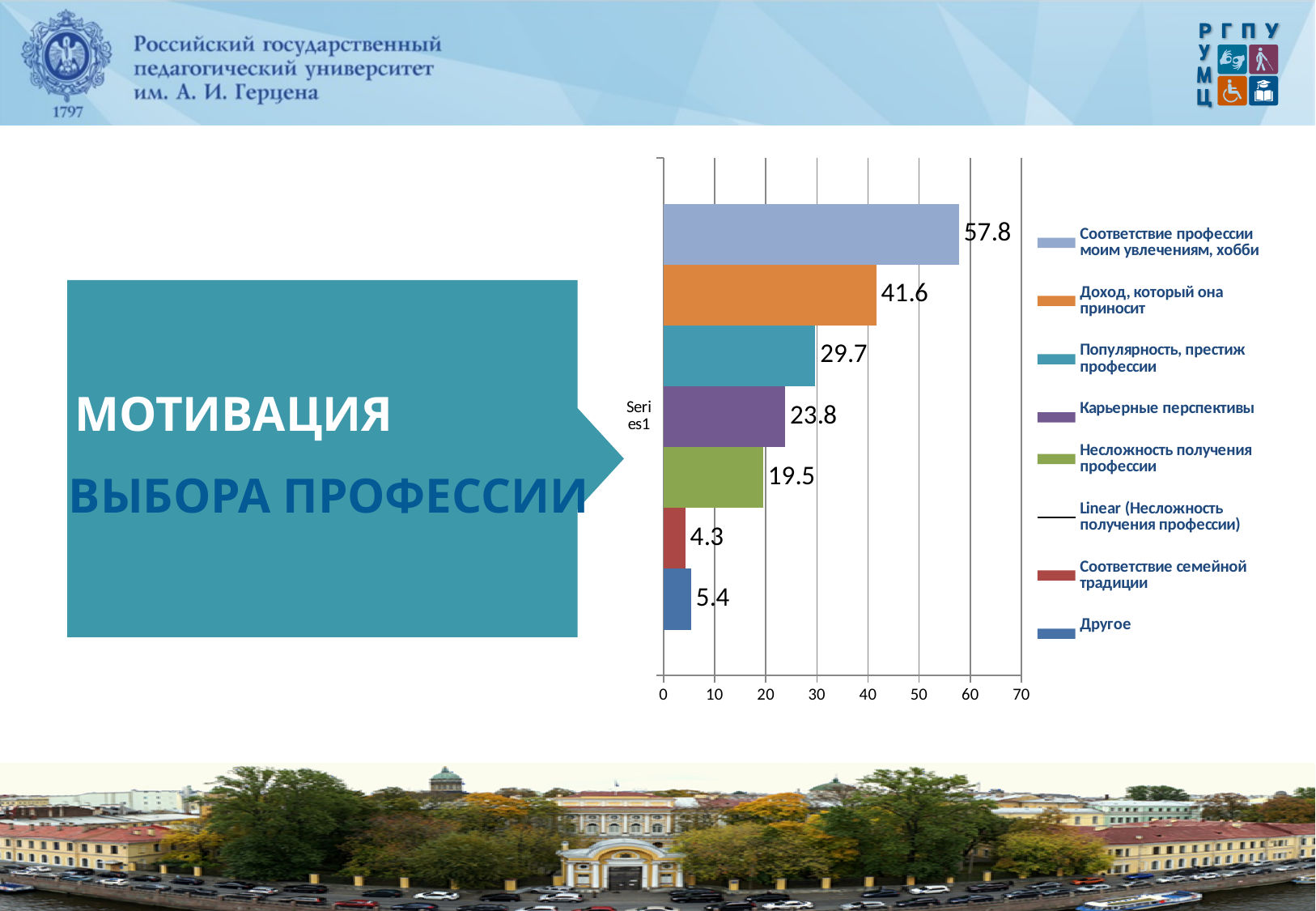
Which category has the lowest value? Соответствие семейной традиции What is the value for "Доход, который она приносит"? 41.6 What is the value for "Карьерные перспективы"? 23.8 Which category has the highest value? Соответствие профессии моим увлечениям, хобби What is the value for "Соответствие семейной традиции"? 4.3 What is the value for "Соответствие профессии моим увлечениям, хобби"? 57.8 What is the difference between the values for "Соответствие профессии моим увлечениям, хобби" and "Доход, который она приносит"? 16.2 How many entries does the chart legend list? 8 How many bars are plotted in the chart? 7 What type of chart is shown on the slide? bar chart Is the value for "Несложность получения профессии" greater or less than 20? less Which is larger: the value for "Популярность, престиж профессии" or the value for "Карьерные перспективы"? Популярность, престиж профессии